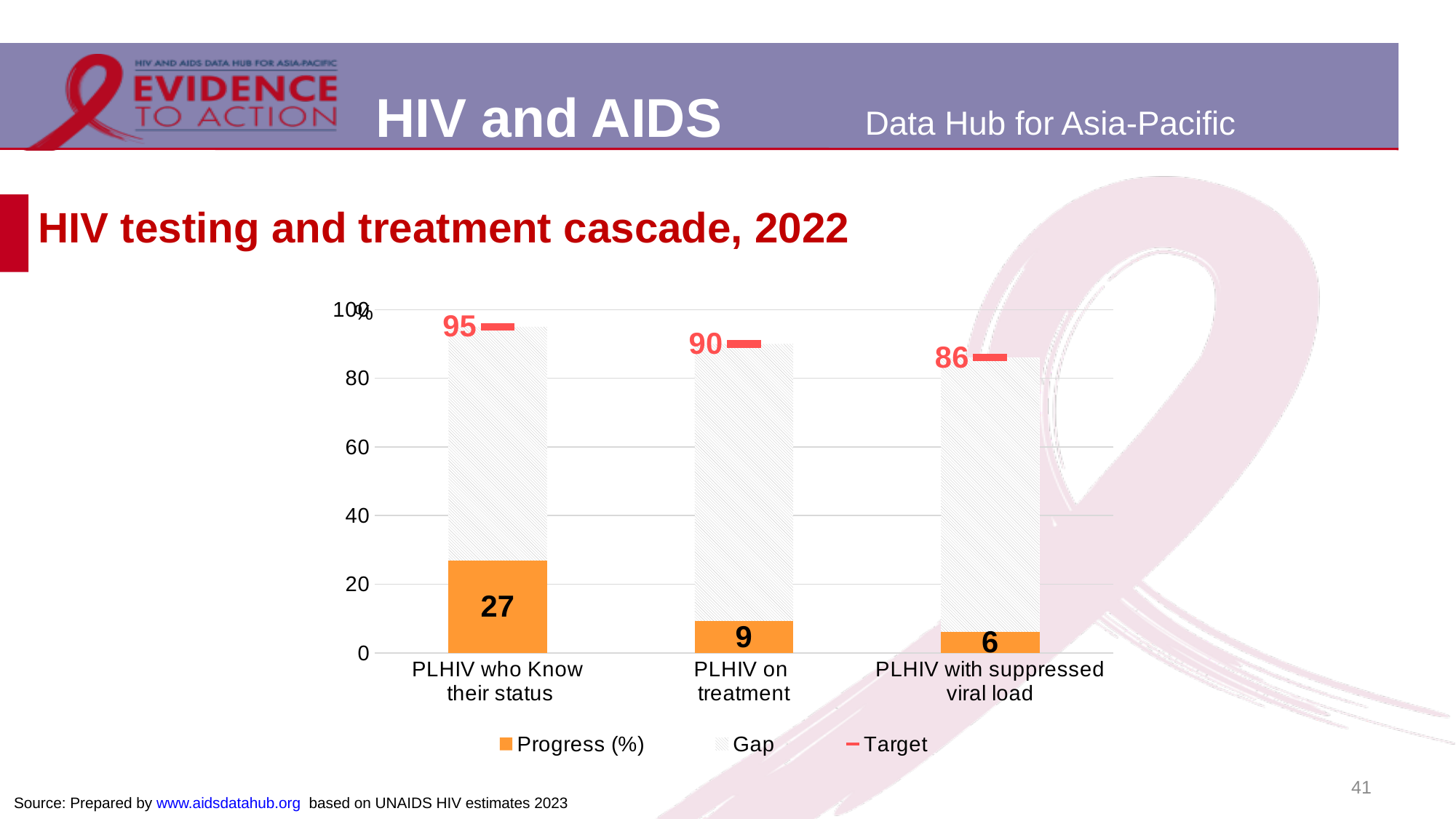
Which category has the lowest Target value? PLHIV with suppressed viral load What is the Target value for PLHIV with suppressed viral load? 86 What is the Progress (%) value for PLHIV on treatment? 9 How many series does the legend list? 3 Do the Progress (%) values rise or fall from left to right along the x axis? fall Which category has the highest Progress (%) value? PLHIV who Know their status What is the difference between the Progress (%) values for PLHIV who Know their status and PLHIV on treatment? 18 What is the Progress (%) value for PLHIV who Know their status? 27 How many categories are shown on the x axis? 3 What is the Target value for PLHIV on treatment? 90 What is the difference between the Target values for PLHIV who Know their status and PLHIV with suppressed viral load? 9 Which is larger, the Progress (%) value for PLHIV on treatment or for PLHIV with suppressed viral load? PLHIV on treatment